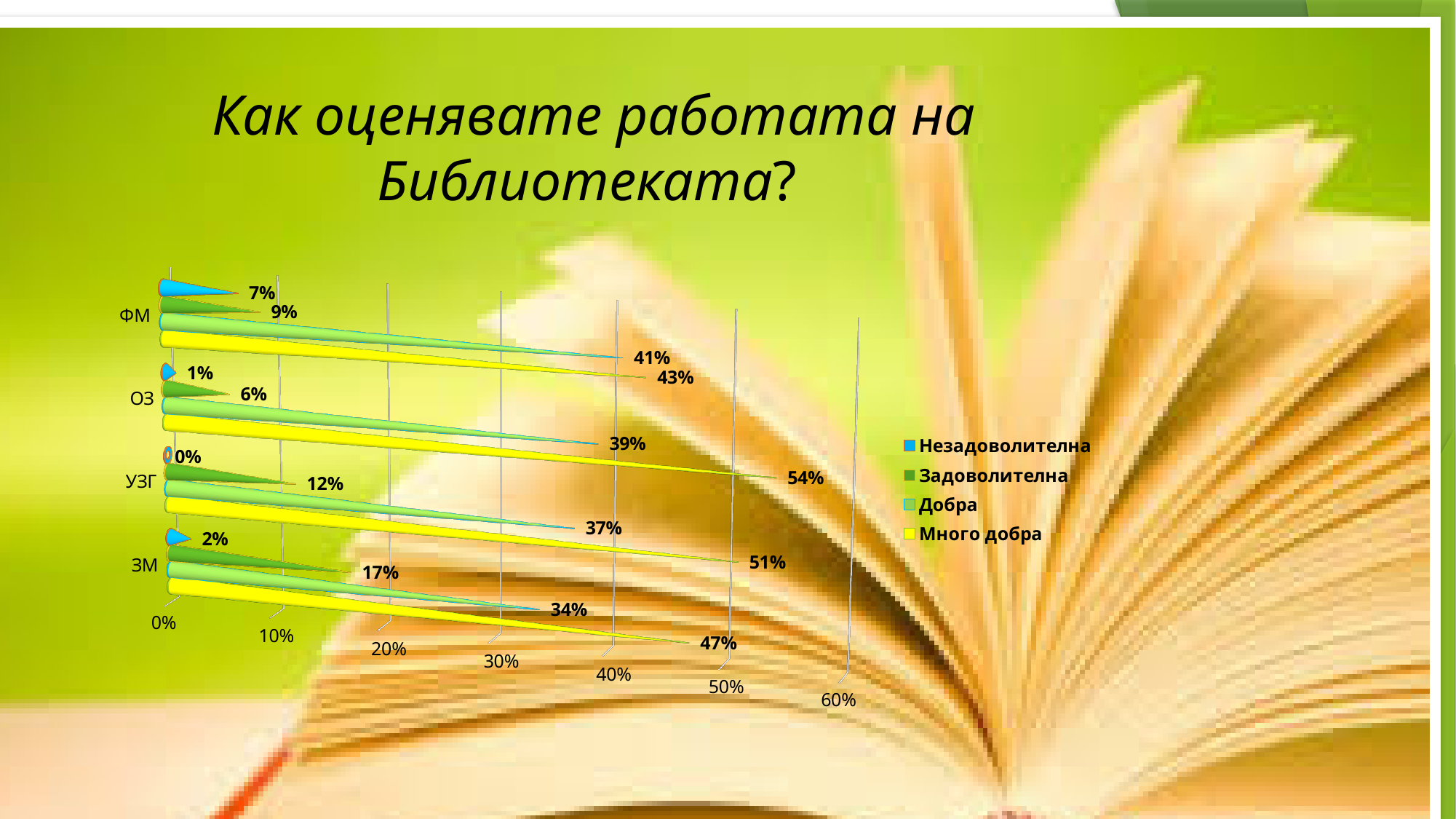
What is the value of Добра for УЗГ? 37% What is the value of Незадоволителна for ФМ? 7% Which is larger for ЗМ: Добра or Много добра? Много добра How many series does the legend list? 4 How many categories are shown on the vertical axis? 4 What is the value of Задоволителна for ЗМ? 17% What is the difference between Много добра and Добра for ФМ? 2% Which category has the highest value for Много добра? ОЗ Which category has the lowest value for Незадоволителна? УЗГ Which legend entry is shown in yellow? Много добра What is the value of Много добра for ОЗ? 54% What kind of chart is shown on the slide? bar chart